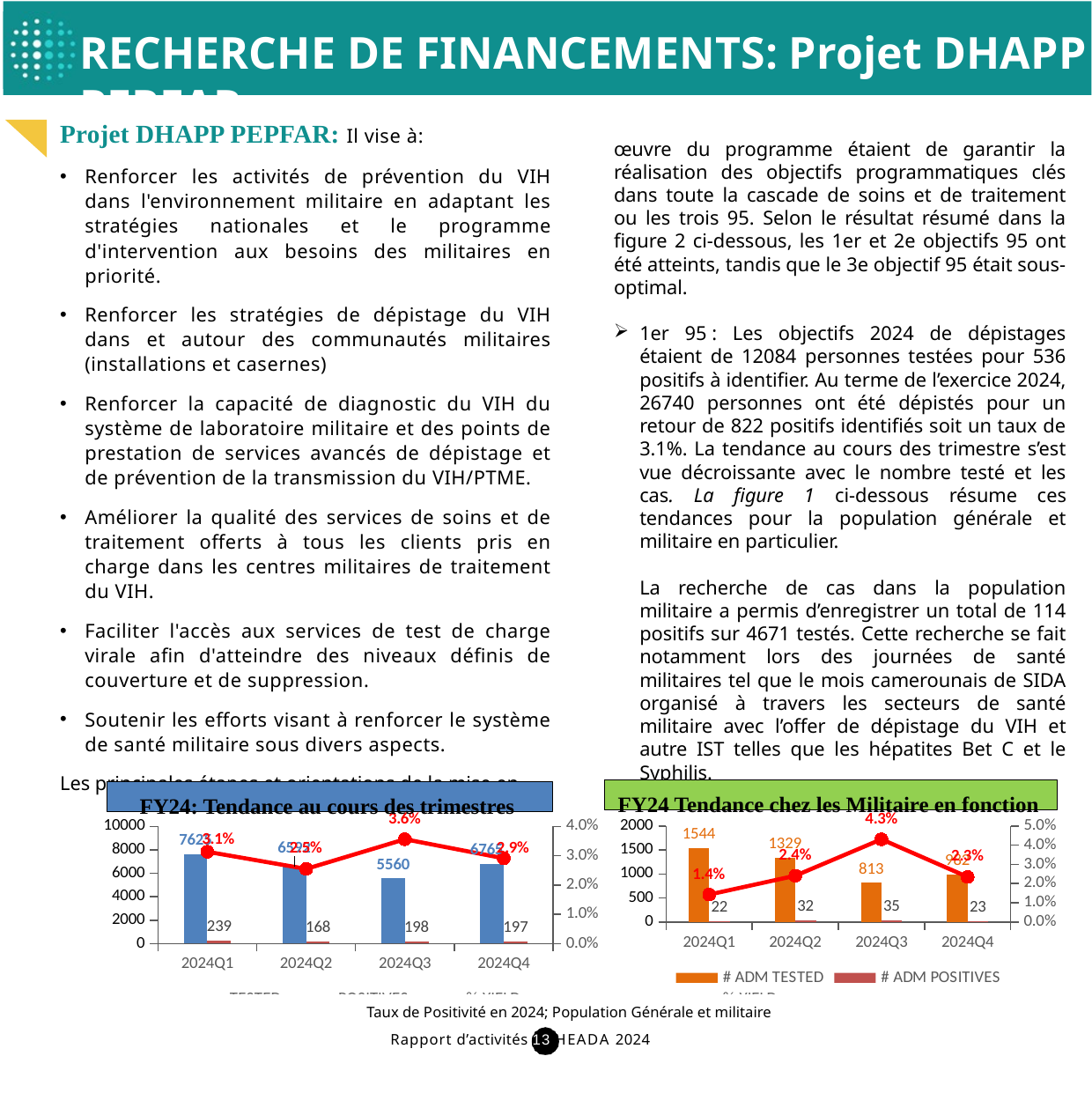
In the chart 'FY24: Tendance au cours des trimestres', what is the TESTED value for 2024Q1? 7625 In the chart 'FY24 Tendance chez les Militaire en fonction', what is the # ADM TESTED value for 2024Q1? 1544 In the chart 'FY24 Tendance chez les Militaire en fonction', what is the difference between the # ADM TESTED values for 2024Q1 and 2024Q3? 731 In the chart 'FY24: Tendance au cours des trimestres', which quarter has the lowest TESTED value? 2024Q3 In the chart 'FY24 Tendance chez les Militaire en fonction', which quarter has the highest % YIELD? 2024Q3 In the chart 'FY24 Tendance chez les Militaire en fonction', what is the # ADM POSITIVES value for 2024Q3? 35 In the chart 'FY24 Tendance chez les Militaire en fonction', how many series does the legend list? 3 In the chart 'FY24: Tendance au cours des trimestres', what is the POSITIVES value for 2024Q2? 168 In the chart 'FY24: Tendance au cours des trimestres', which is larger, the TESTED value for 2024Q1 or for 2024Q4? 2024Q1 In the chart 'FY24: Tendance au cours des trimestres', which quarter has the highest % YIELD? 2024Q3 In the chart 'FY24: Tendance au cours des trimestres', how many quarters are shown on the x axis? 4 In the chart 'FY24: Tendance au cours des trimestres', what is the difference between the POSITIVES values for 2024Q1 and 2024Q4? 42